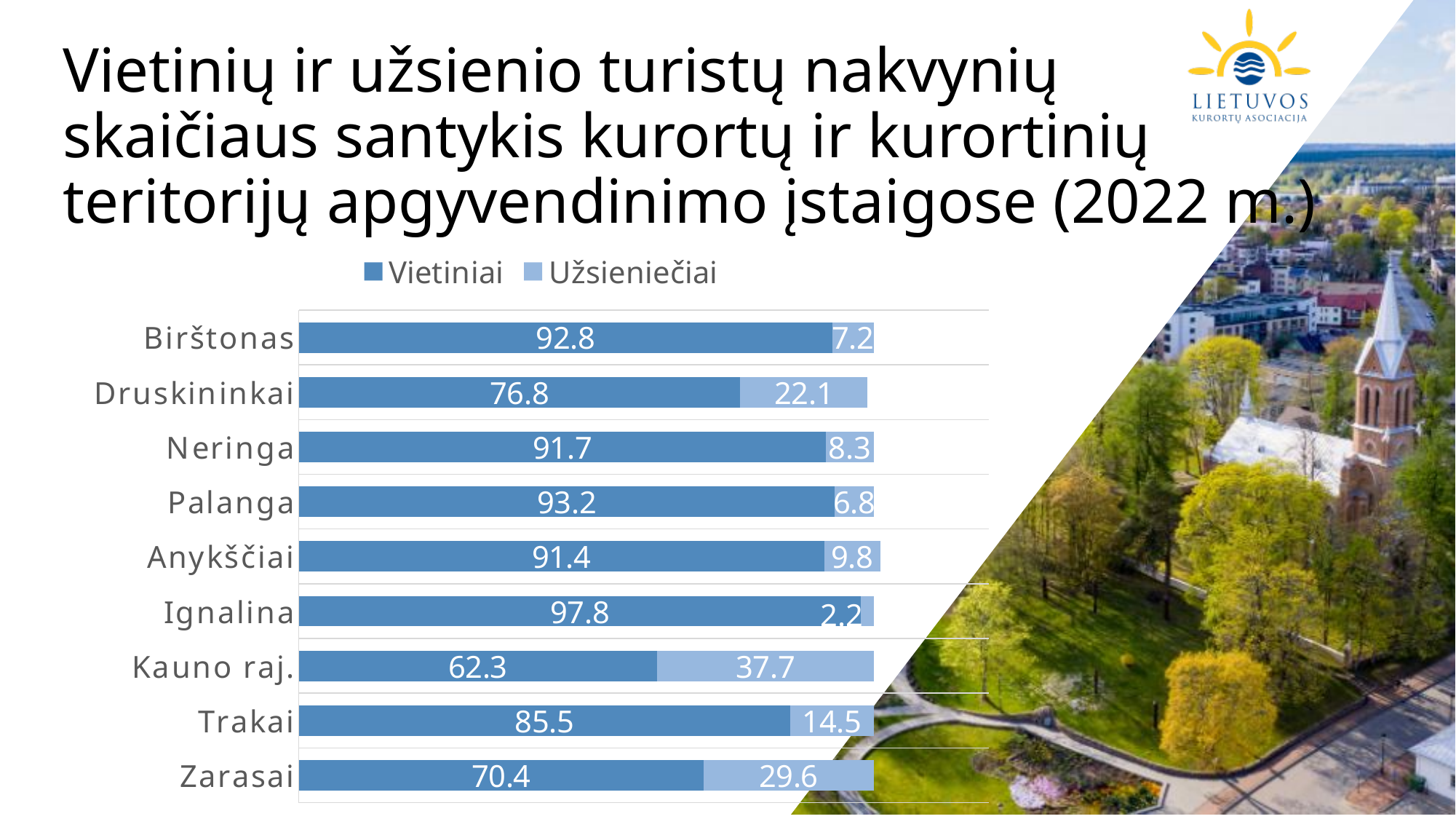
Which category has the highest Užsieniečiai value? Kauno raj. What is the total of the stacked bar for Neringa? 100 Which is larger, the Užsieniečiai value for Druskininkai or for Trakai? Druskininkai Which category has the highest Vietiniai value? Ignalina What is the Vietiniai value for Druskininkai? 76.8 What is the difference between the Vietiniai values for Trakai and Zarasai? 15.1 What kind of chart is shown on the slide? Stacked bar chart How many categories are shown on the chart? 9 What is the Užsieniečiai value for Kauno raj.? 37.7 How many series does the legend list? 2 What is the Užsieniečiai value for Ignalina? 2.2 Which category has the lowest Vietiniai value? Kauno raj.